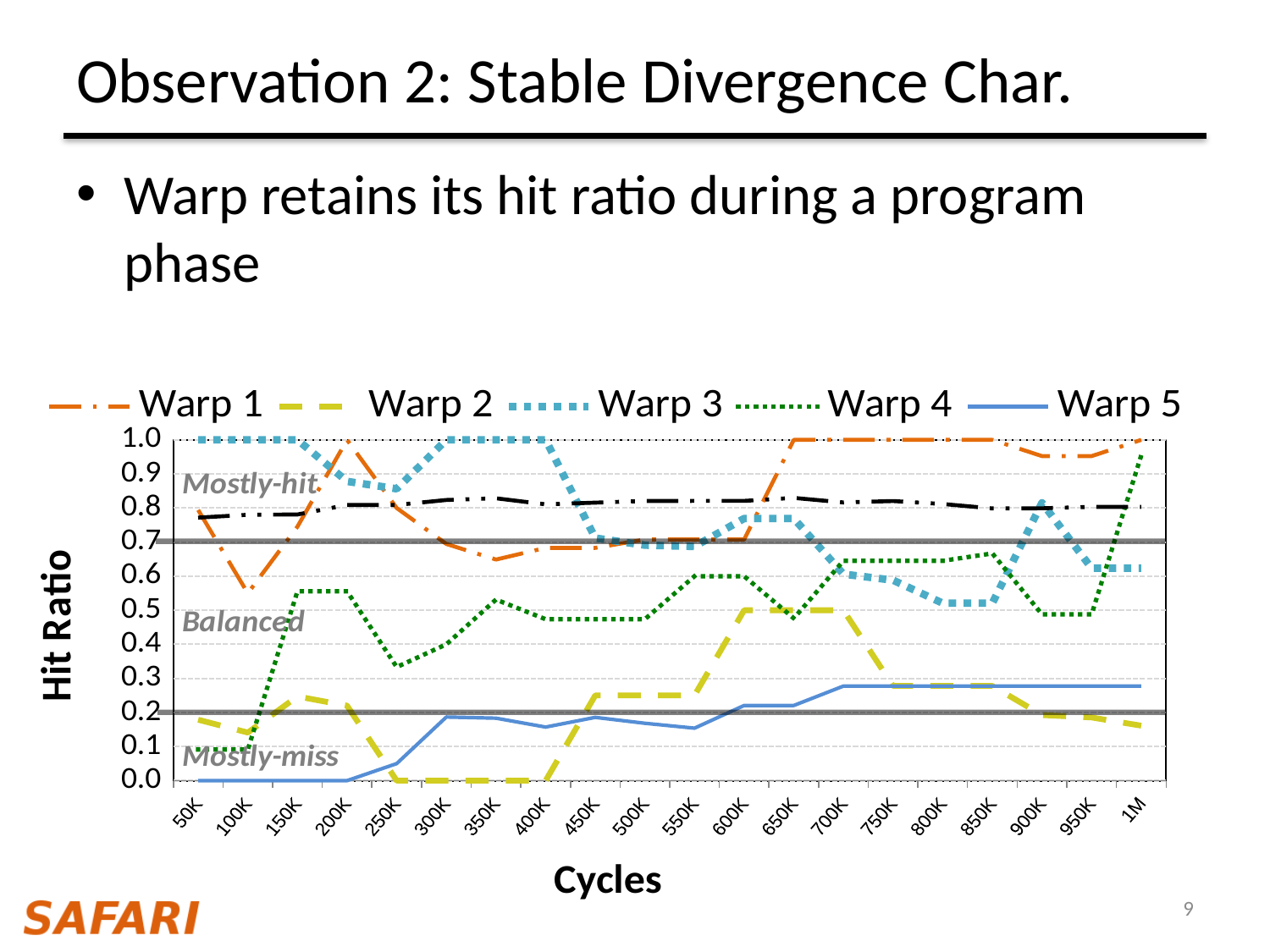
How many points are labelled along the x axis (Cycles)? 20 What is the hit ratio of Warp 5 at 50K cycles? 0.0 Is the hit ratio of Warp 4 at 250K cycles greater or less than 0.4? less Which warp has the lowest hit ratio at 50K cycles? Warp 5 At 650K cycles, which has the higher hit ratio, Warp 1 or Warp 5? Warp 1 What is the hit ratio of Warp 3 at 50K cycles? 1.0 How many series does the legend list? 5 Which warp has the highest hit ratio at 50K cycles? Warp 3 What kind of chart is shown on the slide? line chart What is the label of the x axis? Cycles What is the hit ratio of Warp 1 at 650K cycles? 1.0 Is the hit ratio of Warp 5 at 700K cycles greater or less than 0.2? greater